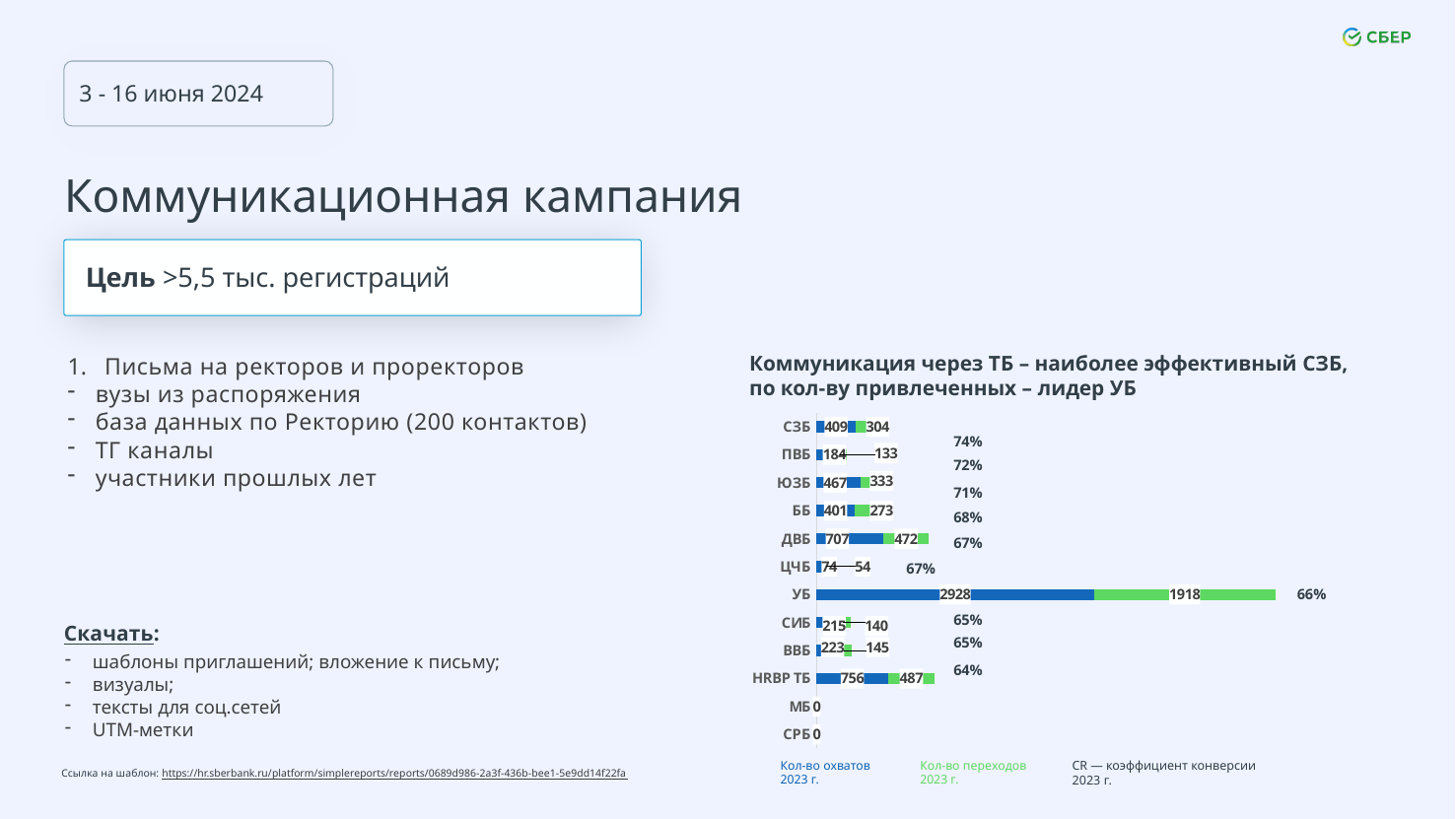
What is the CR (conversion rate) shown for СЗБ? 74% What is the number of reaches (Кол-во охватов) for УБ? 2928 What is the number of transitions (Кол-во переходов) for ДВБ? 472 What type of chart is shown on the slide? bar chart Which has more reaches (Кол-во охватов): ЮЗБ or ББ? ЮЗБ Among categories with non-zero values, which has the lowest number of transitions (Кол-во переходов)? ЦЧБ How many data series does the chart legend list (excluding the CR note)? 2 What colour represents Кол-во переходов 2023 г. in the chart? green How many categories are listed on the vertical axis of the chart? 12 What is the difference between reaches and transitions for HRBP ТБ? 269 Which category has the highest number of reaches (Кол-во охватов)? УБ